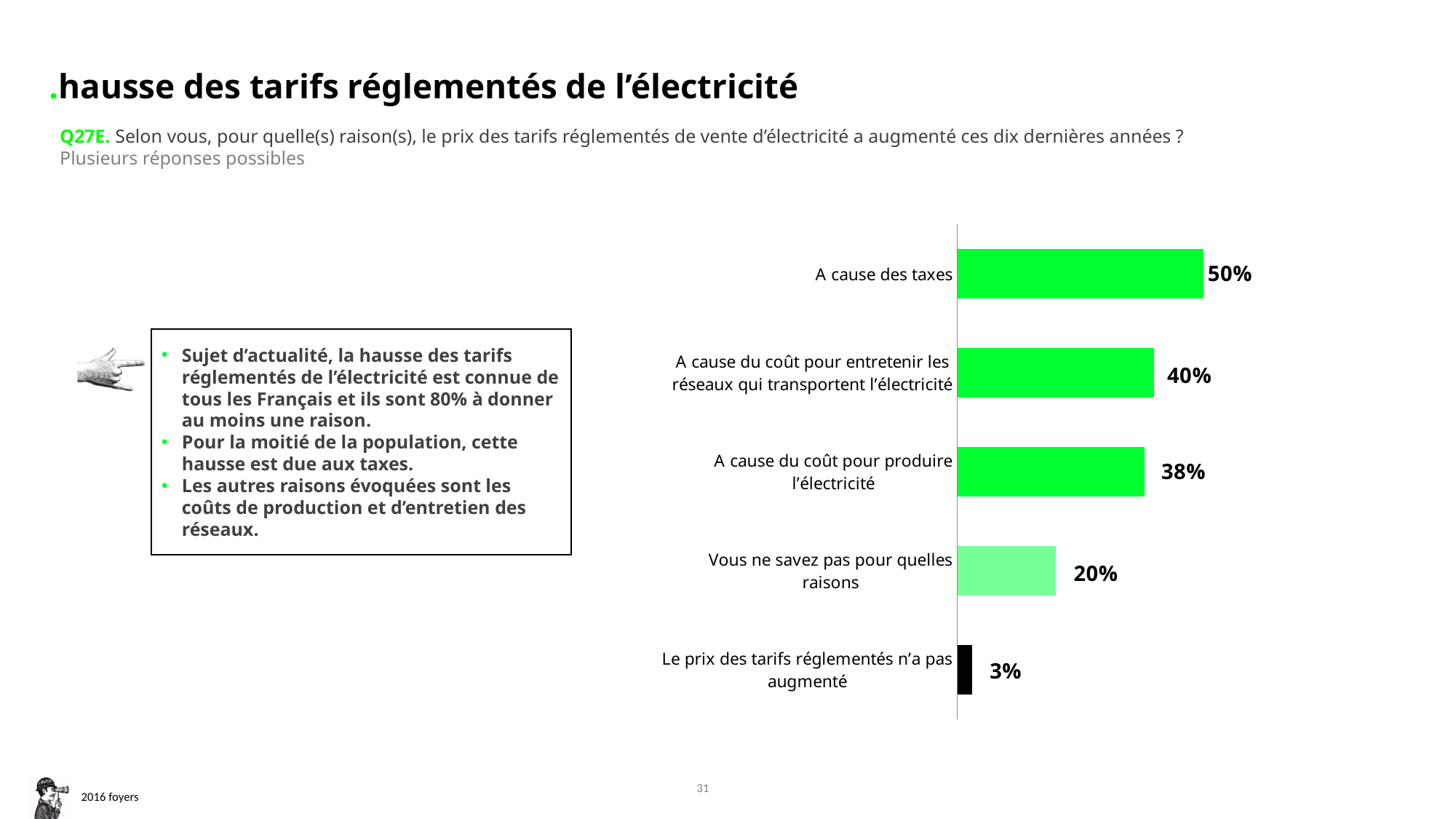
What is the value for "Vous ne savez pas pour quelles raisons"? 20% What kind of chart is shown on the slide? Bar chart Which category has the highest value? A cause des taxes What is the value for "A cause des taxes"? 50% What is the difference between the values for "A cause des taxes" and "Vous ne savez pas pour quelles raisons"? 30% Which is larger: the value for "A cause du coût pour entretenir les réseaux qui transportent l'électricité" or the value for "Vous ne savez pas pour quelles raisons"? A cause du coût pour entretenir les réseaux qui transportent l'électricité How many categories are shown in the chart? 5 Which category has the lowest value? Le prix des tarifs réglementés n'a pas augmenté What is the value for "Le prix des tarifs réglementés n'a pas augmenté"? 3% What is the value for "A cause du coût pour entretenir les réseaux qui transportent l'électricité"? 40% What is the value for "A cause du coût pour produire l'électricité"? 38% Which bar is coloured black? Le prix des tarifs réglementés n'a pas augmenté